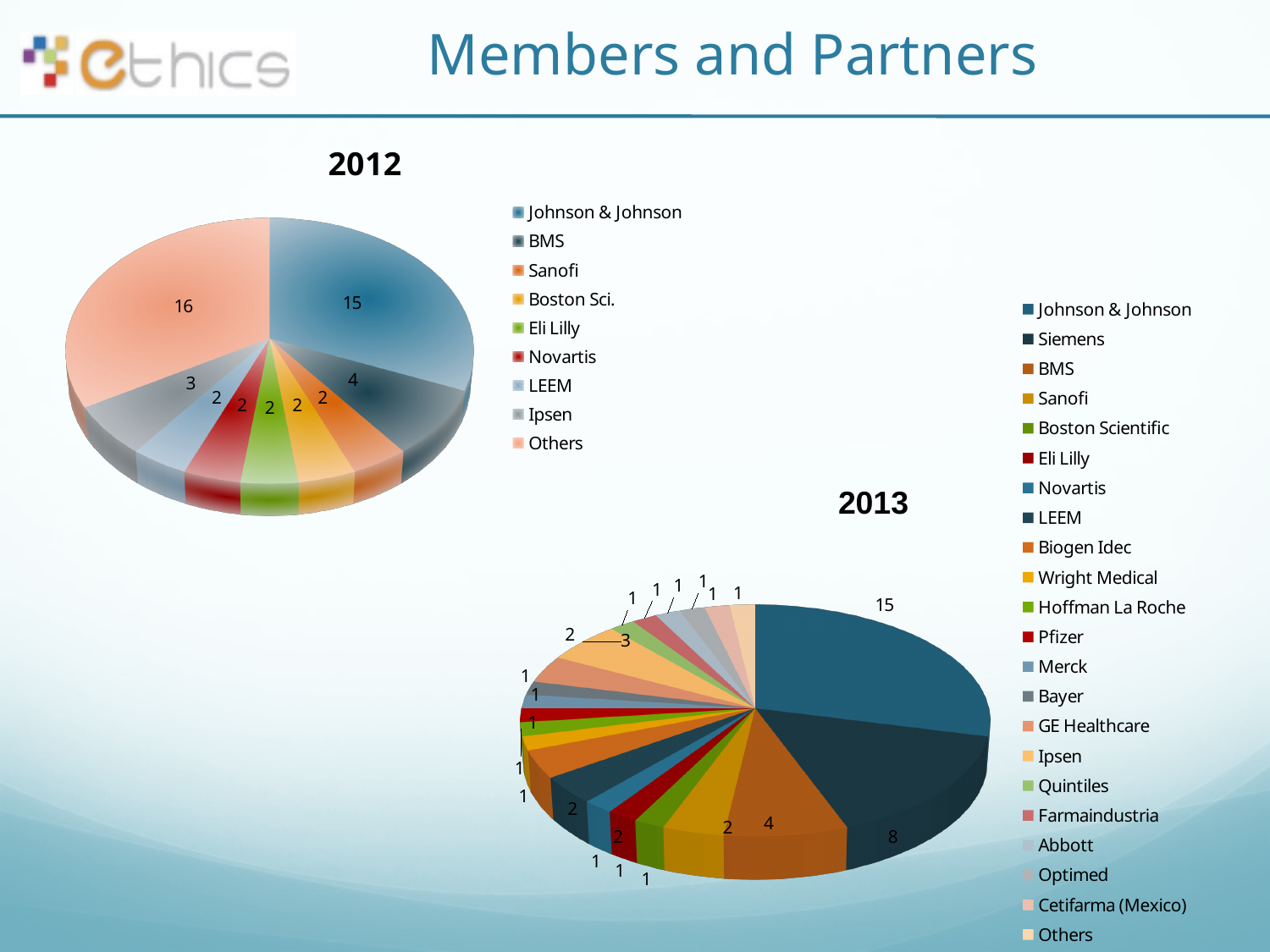
In the 2013 chart, which category has the largest slice? Johnson & Johnson In the 2013 chart, what is the value for Siemens? 8 What kind of chart is the 2012 chart? pie chart How many categories does the 2012 chart's legend list? 9 In the 2012 chart, what is the value for BMS? 4 How many categories does the 2013 chart's legend list? 22 In the 2012 chart, what is the value for Others? 16 In the 2012 chart, which category has the largest slice? Others In the 2013 chart, what is the value for Johnson & Johnson? 15 In the 2012 chart, what is the difference between the values for Others and Johnson & Johnson? 1 In the 2012 chart, which is larger, the value for BMS or the value for Ipsen? BMS In the 2012 chart, what is the value for Johnson & Johnson? 15